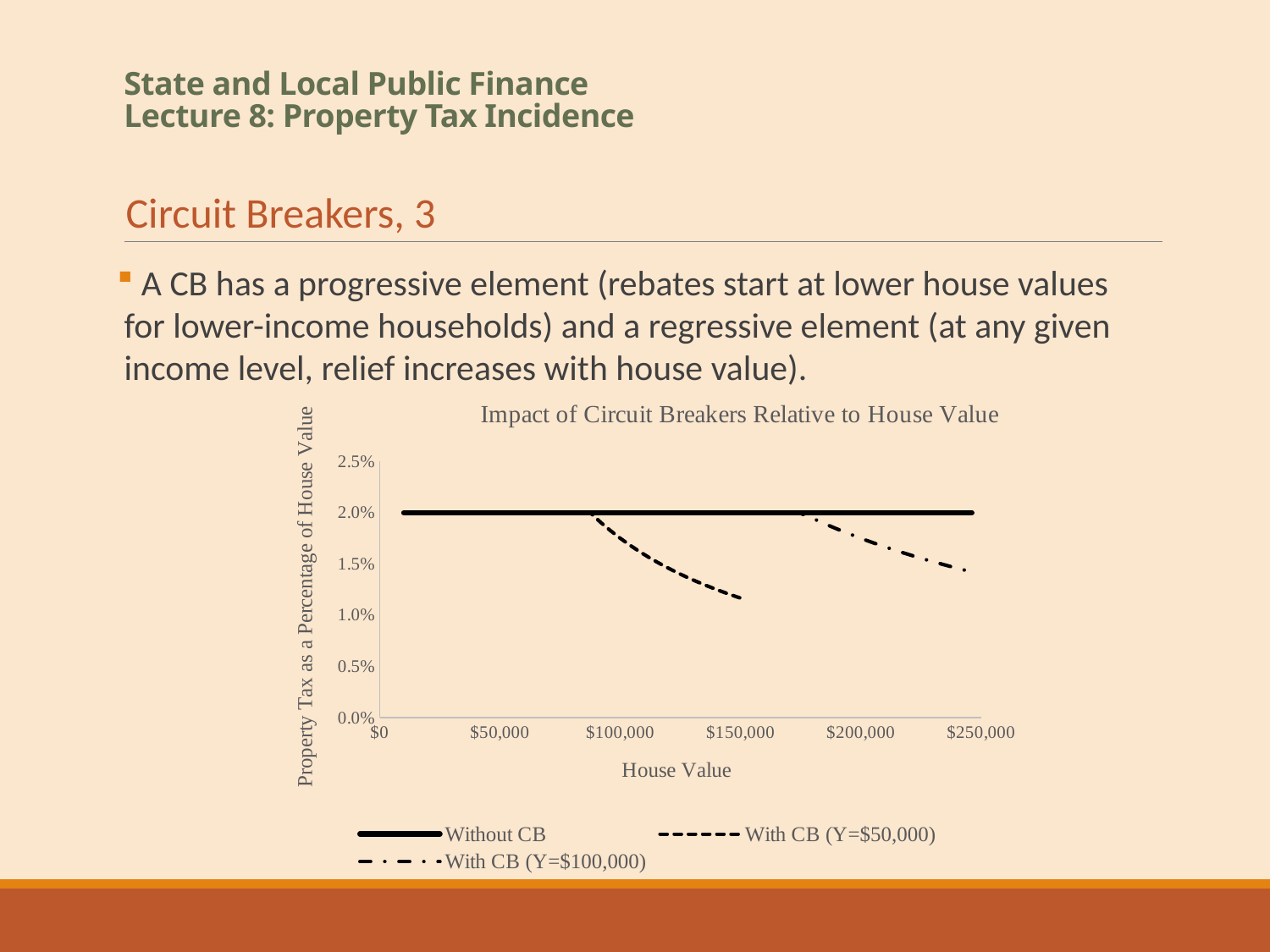
What is the title of the chart? Impact of Circuit Breakers Relative to House Value What kind of chart is shown on the slide? line chart At a house value of $150,000, which series has the higher value: Without CB or With CB (Y=$50,000)? Without CB Is the value of the With CB (Y=$100,000) line at $200,000 greater or less than 1.5%? greater How many series does the chart's legend list? 3 Does the With CB (Y=$100,000) line rise or fall as house value increases beyond $200,000? fall Does the With CB (Y=$50,000) line rise or fall as house value increases beyond $100,000? fall What is the label of the x axis? House Value Which series has the lowest value at a house value of $150,000? With CB (Y=$50,000) Is the value of the With CB (Y=$50,000) line at $150,000 greater or less than 1.5%? less Is the value of the With CB (Y=$50,000) line at $150,000 greater or less than 1.0%? greater What value does the Without CB line stay at across all house values? 2.0%